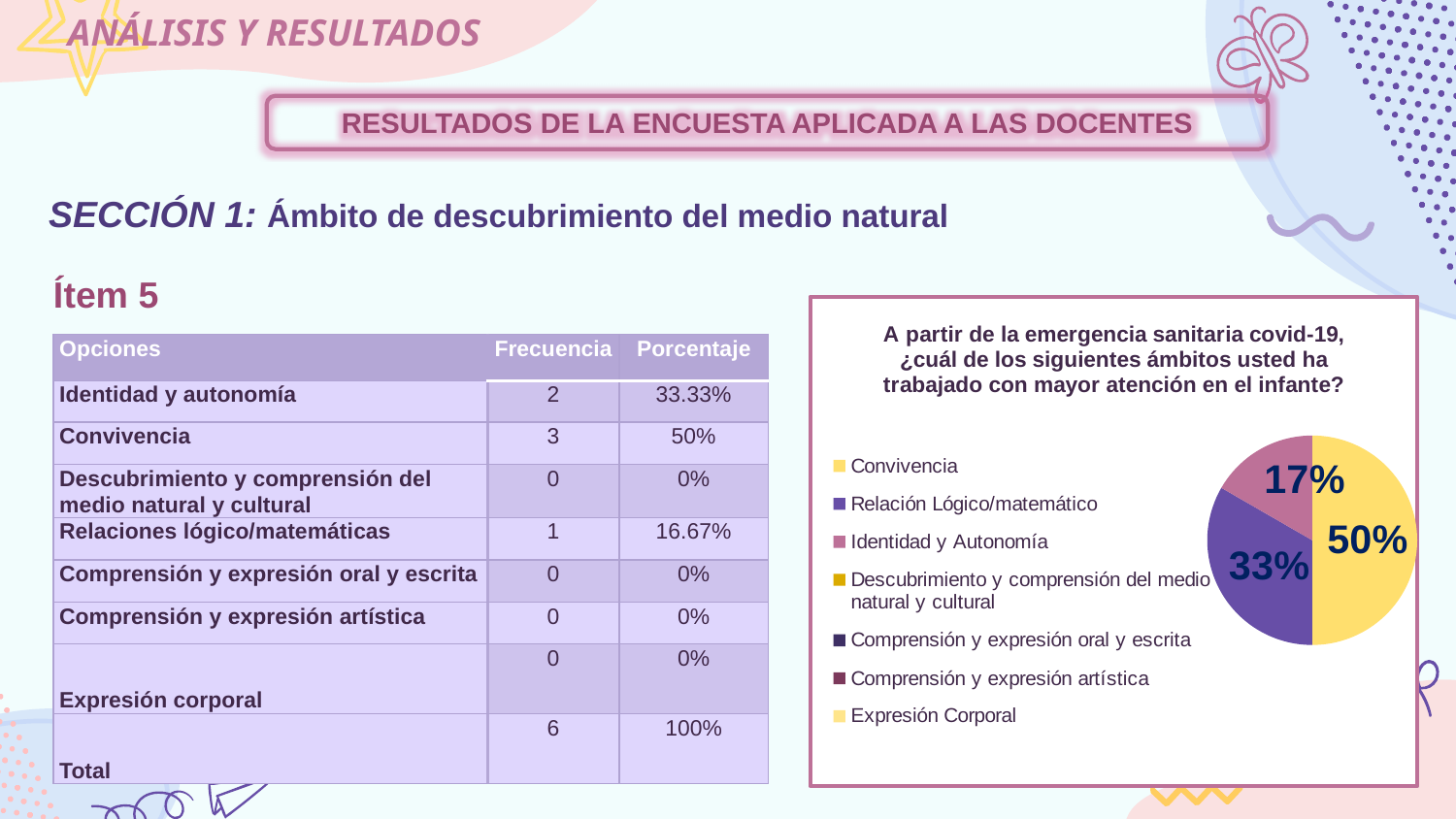
What is the combined share of the 33% and 17% slices of the pie chart? 50% What is the title of the pie chart? A partir de la emergencia sanitaria covid-19, ¿cuál de los siguientes ámbitos usted ha trabajado con mayor atención en el infante? How many entries does the legend of the pie chart list? 7 What percentage does the largest slice of the pie chart show? 50% What is the difference between the 50% slice and the 17% slice of the pie chart? 33% What colour is the Convivencia slice in the pie chart? yellow What percentage is shown on the purple slice of the pie chart? 33% What kind of chart is shown on the slide? pie chart What percentage does the smallest labelled slice of the pie chart show? 17% How many slices with a percentage label does the pie chart have? 3 Is the 50% slice of the pie chart larger or smaller than the 33% slice? larger Which legend category corresponds to the 50% slice of the pie chart? Convivencia